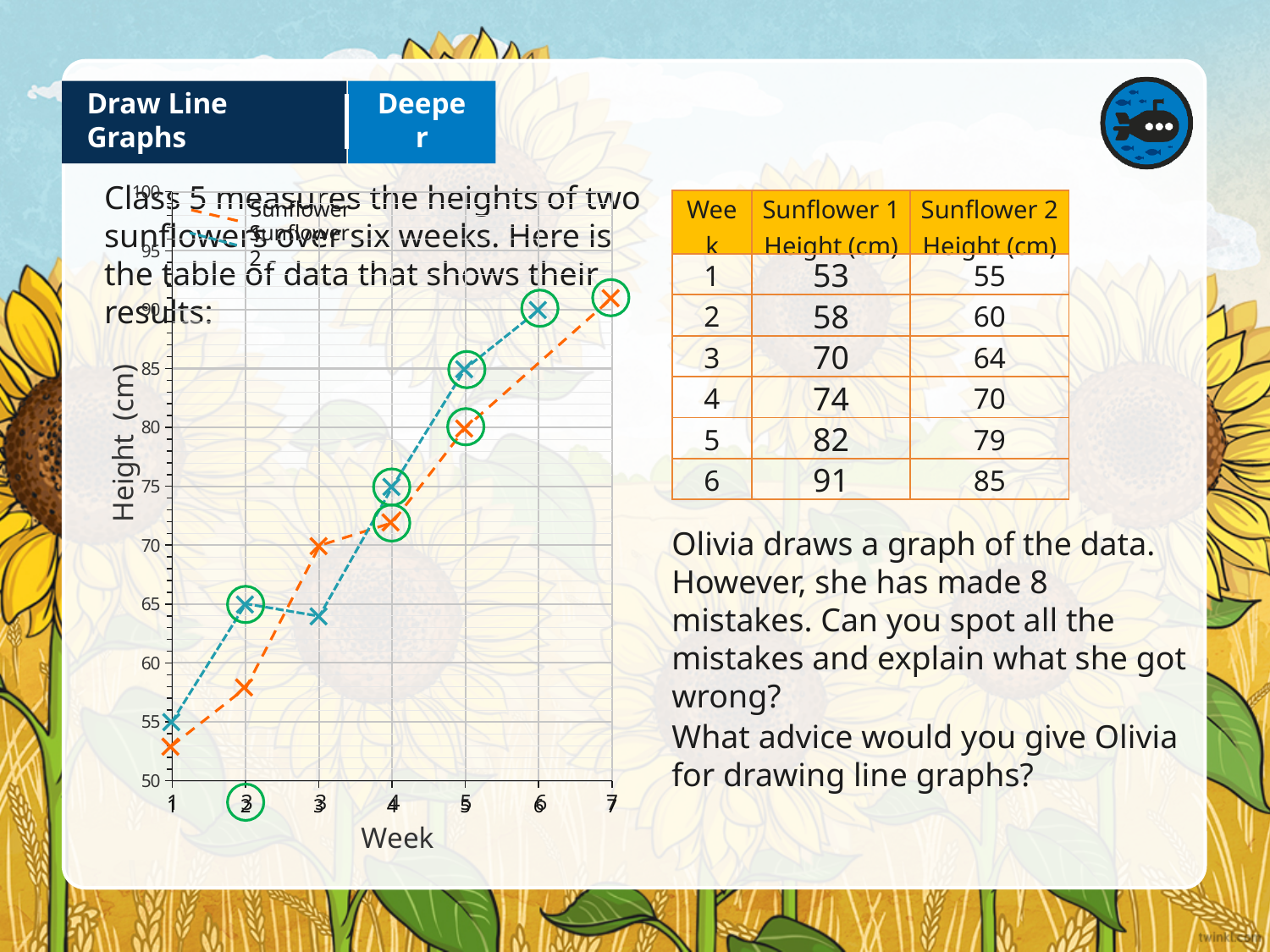
Is the value of the blue dotted line at week 2 greater or less than 60? greater At week 3, which line is higher on the chart, the orange dashed line or the blue dotted line? orange dashed line How many week values are marked along the x axis of the chart? 7 How many series does the chart's legend list? 2 Is the value of the orange dashed line at week 4 greater or less than 75? less What kind of chart is shown on the slide? line chart Is the value of the orange dashed line at week 1 greater or less than 55? less What is the title of the chart's horizontal axis? Week At week 2, which line is higher on the chart, the orange dashed line or the blue dotted line? blue dotted line What is the title of the chart's vertical axis? Height (cm) Does the blue dotted line overall rise or fall from week 1 to week 6? rise